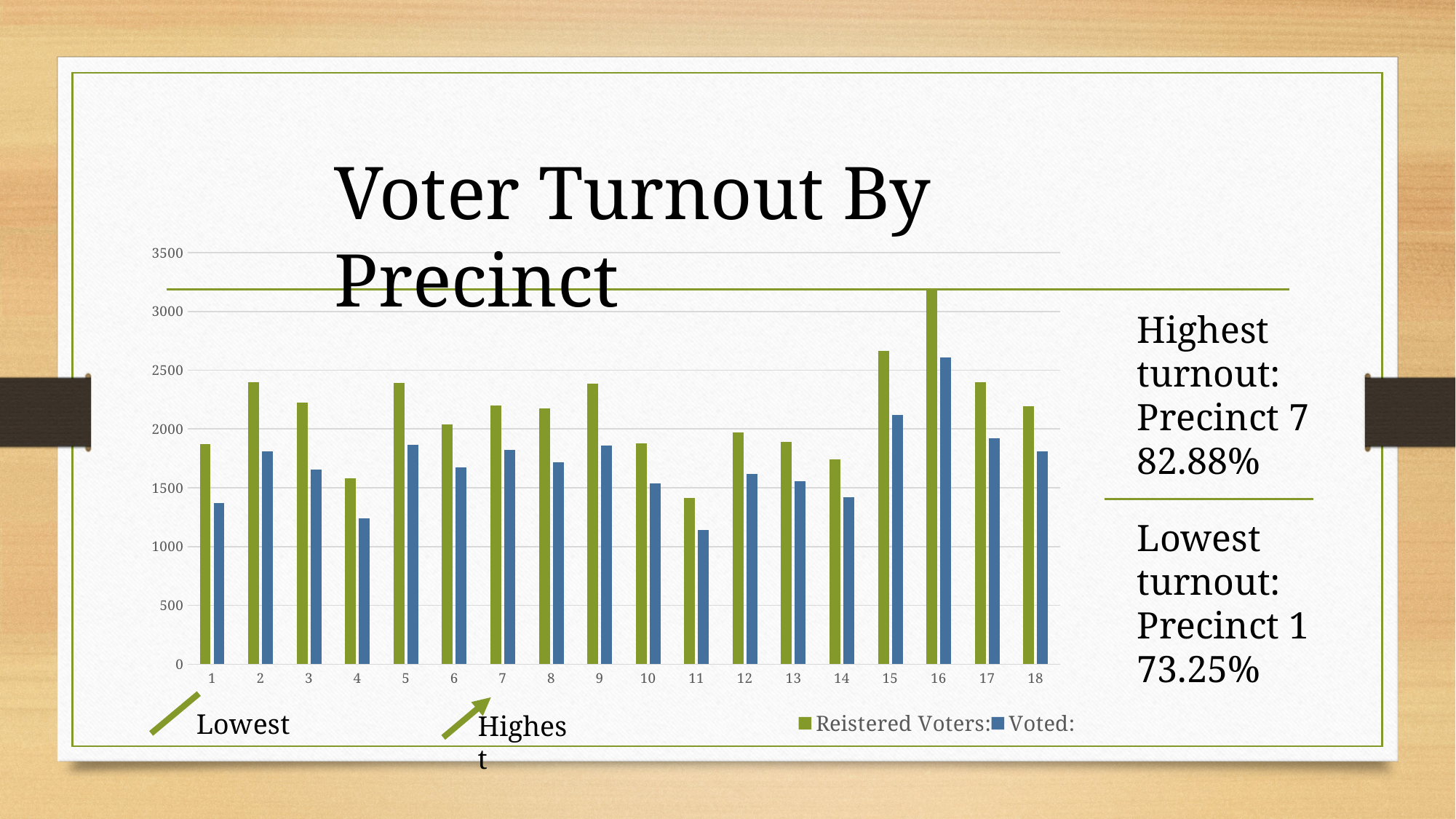
Which precinct has the highest number of registered voters? 16 How many precincts are shown on the x axis? 18 Is the Voted value for precinct 15 greater or less than 2000? greater Which precinct has the highest Voted value? 16 Is the Voted value for precinct 11 greater or less than 1500? less What is the title of the chart? Voter Turnout By Precinct Is the Registered Voters value for precinct 16 greater or less than 3000? greater Which precinct has the lowest Voted value? 11 Which has more registered voters, precinct 15 or precinct 4? precinct 15 How many series does the legend list? 2 Which precinct has the lowest number of registered voters? 11 What kind of chart is shown on the slide? bar chart